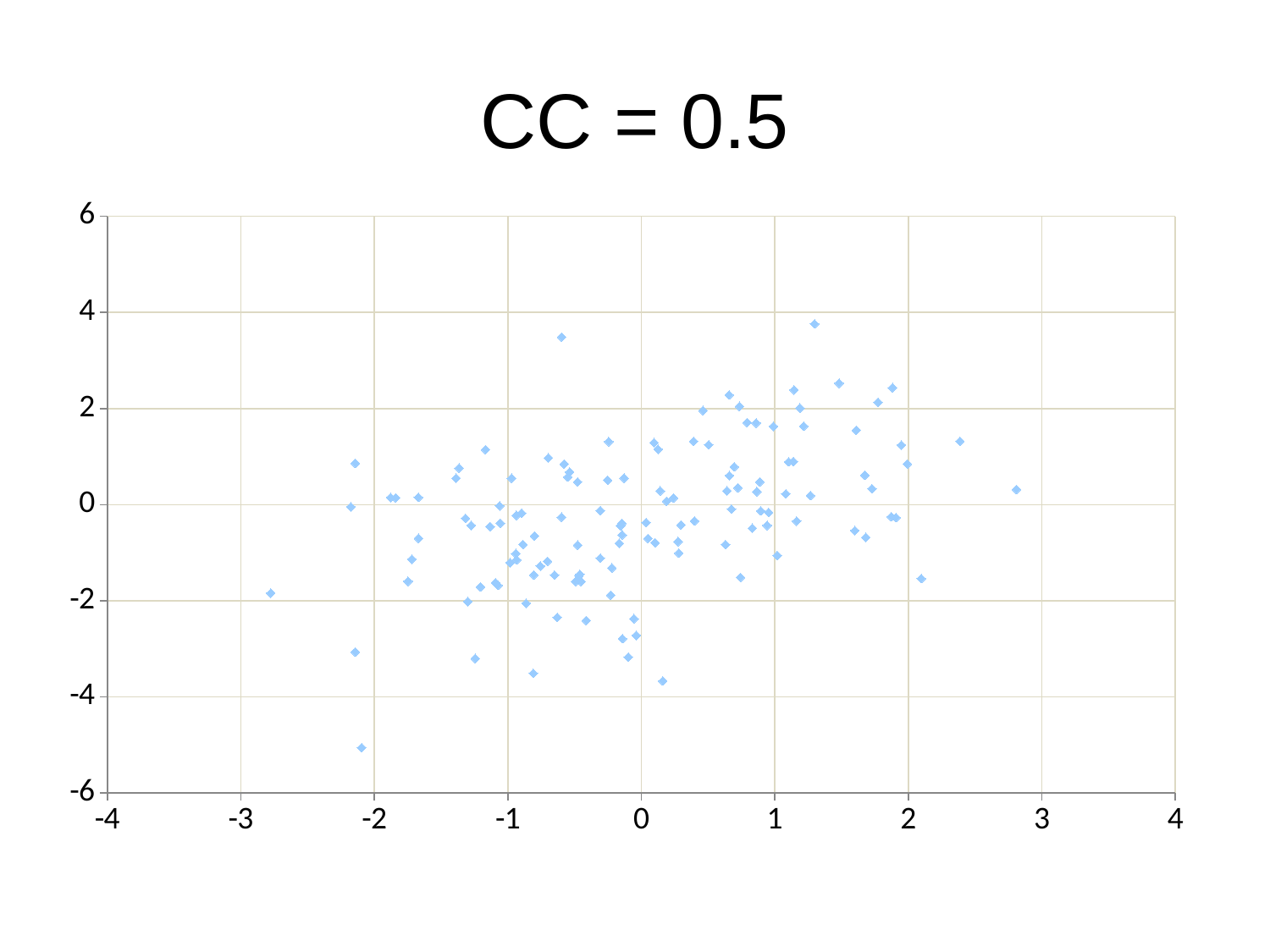
Do the plotted y values tend to rise or fall as x increases along the x axis? rise Is the y value of the lowest point on the chart greater or less than -4? less What are the minimum and maximum values shown on the y axis? -6 and 6 What is the title of the chart? CC = 0.5 What kind of chart is shown on the slide? scatter chart Is the y value of the highest point on the chart greater or less than 4? less Is the x value of the leftmost point on the chart greater or less than -3? greater